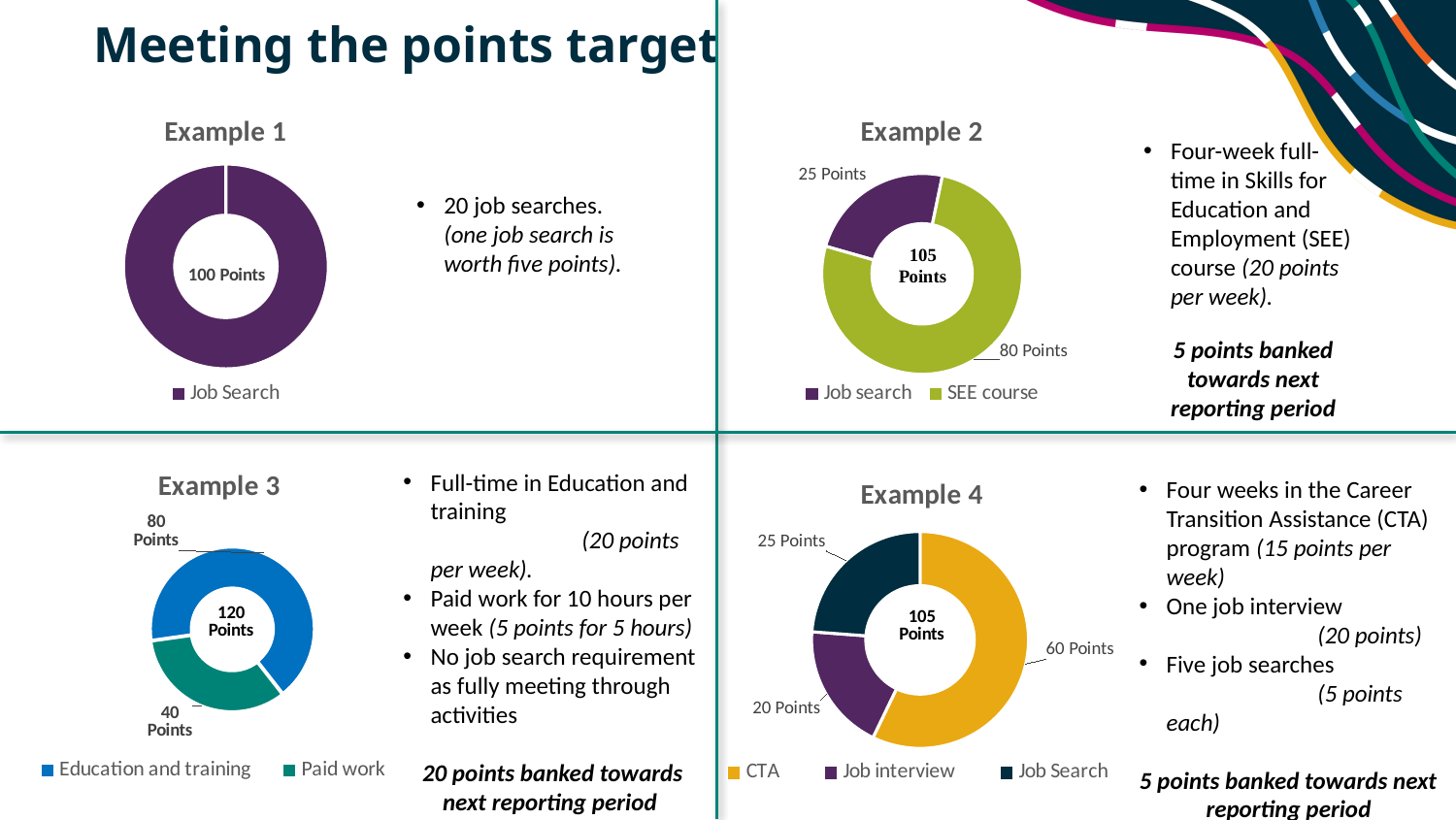
What is the only category shown in the legend of the Example 1 chart? Job Search In the Example 4 chart, which category contributes the fewest points? Job interview What kind of chart is used for Example 1? Doughnut chart In the Example 2 chart, how many points does the SEE course contribute? 80 Points In the Example 4 chart, what is the total number of points shown in the centre? 105 Points In the Example 4 chart, which category contributes the most points? CTA How many categories does the legend of the Example 4 chart list? 3 In the Example 4 chart, how many points does CTA contribute? 60 Points In the Example 2 chart, which contributes more points, Job search or SEE course? SEE course In the Example 2 chart, how many points does Job search contribute? 25 Points In the Example 3 chart, what is the difference in points between Education and training and Paid work? 40 Points In the Example 3 chart, how many points does Paid work contribute? 40 Points